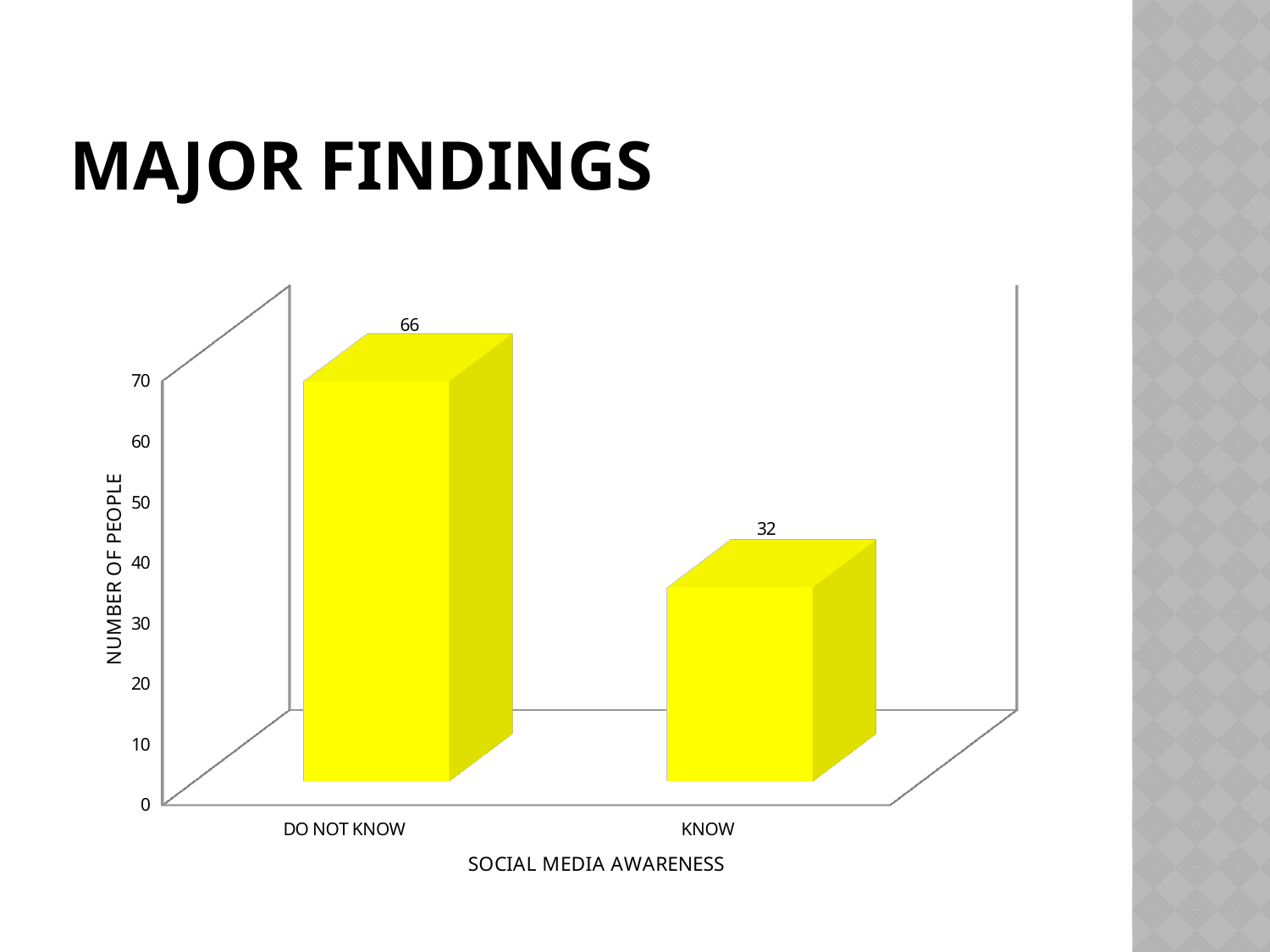
What is the label of the y axis? NUMBER OF PEOPLE How many categories are shown on the x axis? 2 Which category has the lowest value? KNOW What kind of chart is shown on the slide? bar chart What is the value for DO NOT KNOW? 66 Which is larger, the value for DO NOT KNOW or the value for KNOW? DO NOT KNOW What is the value for KNOW? 32 What is the difference between the values for DO NOT KNOW and KNOW? 34 What is the label of the x axis? SOCIAL MEDIA AWARENESS Which category has the highest value? DO NOT KNOW Is the value for DO NOT KNOW greater or less than 60? greater Is the value for KNOW greater or less than 40? less